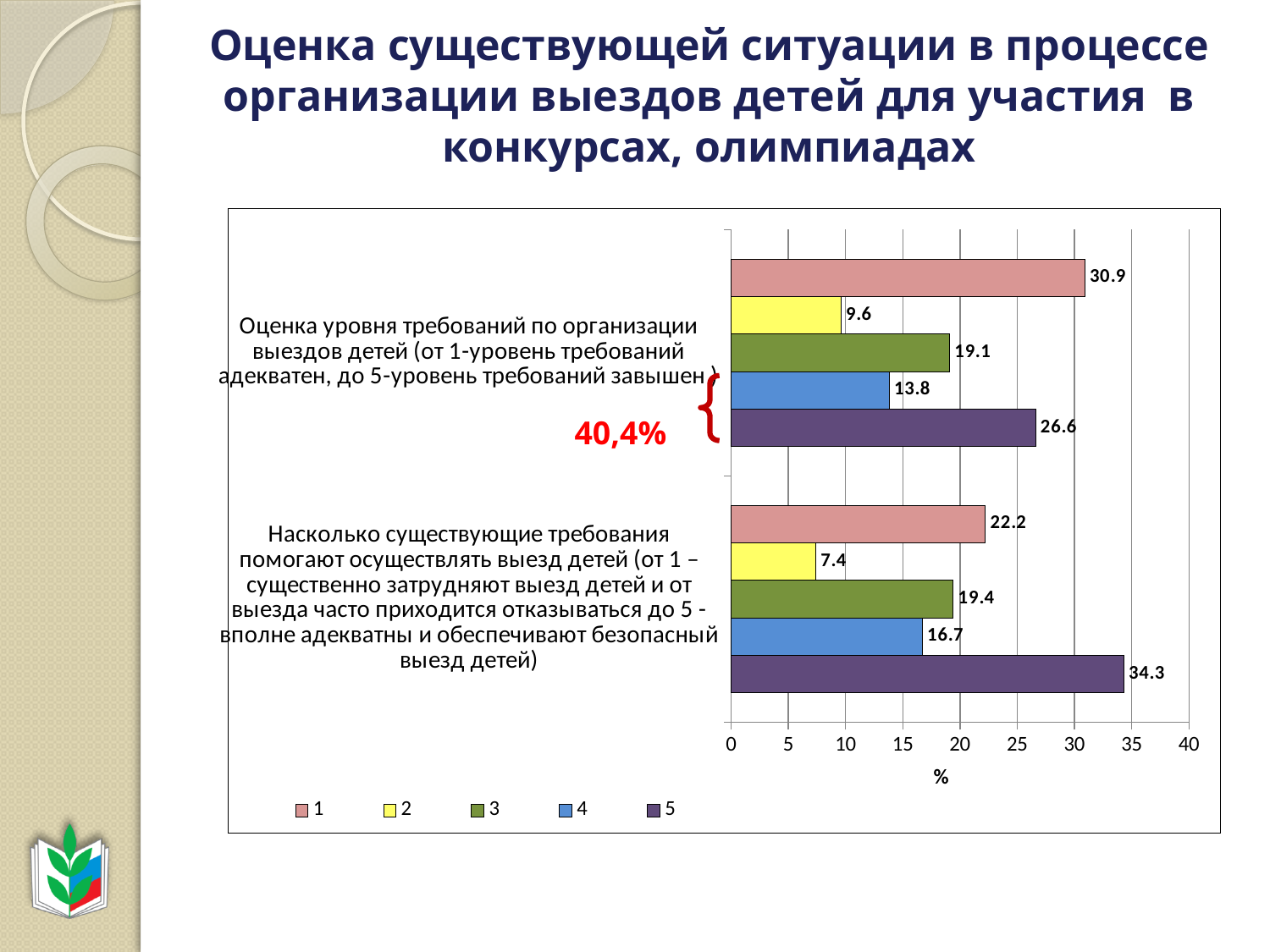
Which series has the highest value in the category 'Насколько существующие требования помогают осуществлять выезд детей'? 5 What is the difference between series 1 and series 5 in the category 'Оценка уровня требований по организации выездов детей'? 4.3 Which series has the lowest value in the category 'Оценка уровня требований по организации выездов детей'? 2 What is the value for series 2 in the category 'Насколько существующие требования помогают осуществлять выезд детей'? 7.4 How many series does the legend list? 5 Which is larger: series 3 in 'Оценка уровня требований по организации выездов детей' or series 3 in 'Насколько существующие требования помогают осуществлять выезд детей'? Насколько существующие требования помогают осуществлять выезд детей What is the value for series 1 in the category 'Оценка уровня требований по организации выездов детей'? 30.9 What type of chart is shown on the slide? bar chart What label is shown on the horizontal axis of the chart? % How many categories are plotted on the chart? 2 What is the value for series 5 in the category 'Насколько существующие требования помогают осуществлять выезд детей'? 34.3 What colour is series 5 in the legend? purple